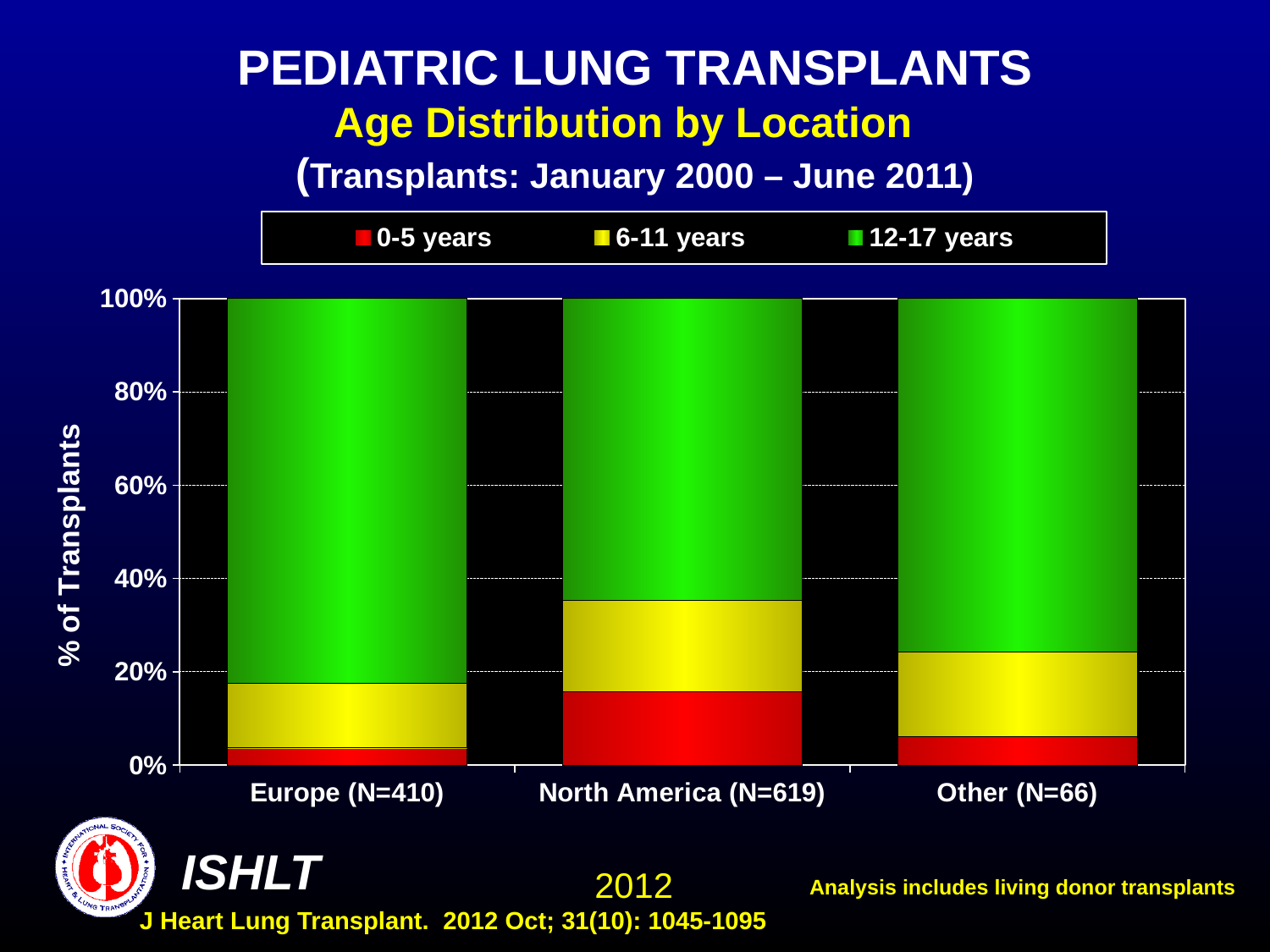
Is the 6-11 years share larger for North America (N=619) or for Europe (N=410)? North America (N=619) How many series does the legend list? 3 Which location has the largest 0-5 years share? North America (N=619) Which location has the smallest 0-5 years share? Europe (N=410) Is the 12-17 years share for North America (N=619) greater or less than 80%? less Is the 12-17 years share for Europe (N=410) greater or less than 80%? greater Which location has the largest 12-17 years share? Europe (N=410) How many location categories are shown on the x axis? 3 Which age group is shown in green in the legend? 12-17 years What kind of chart is shown on the slide? Stacked bar chart Is the 0-5 years share for North America (N=619) greater or less than 20%? less What is the N value shown for North America? 619